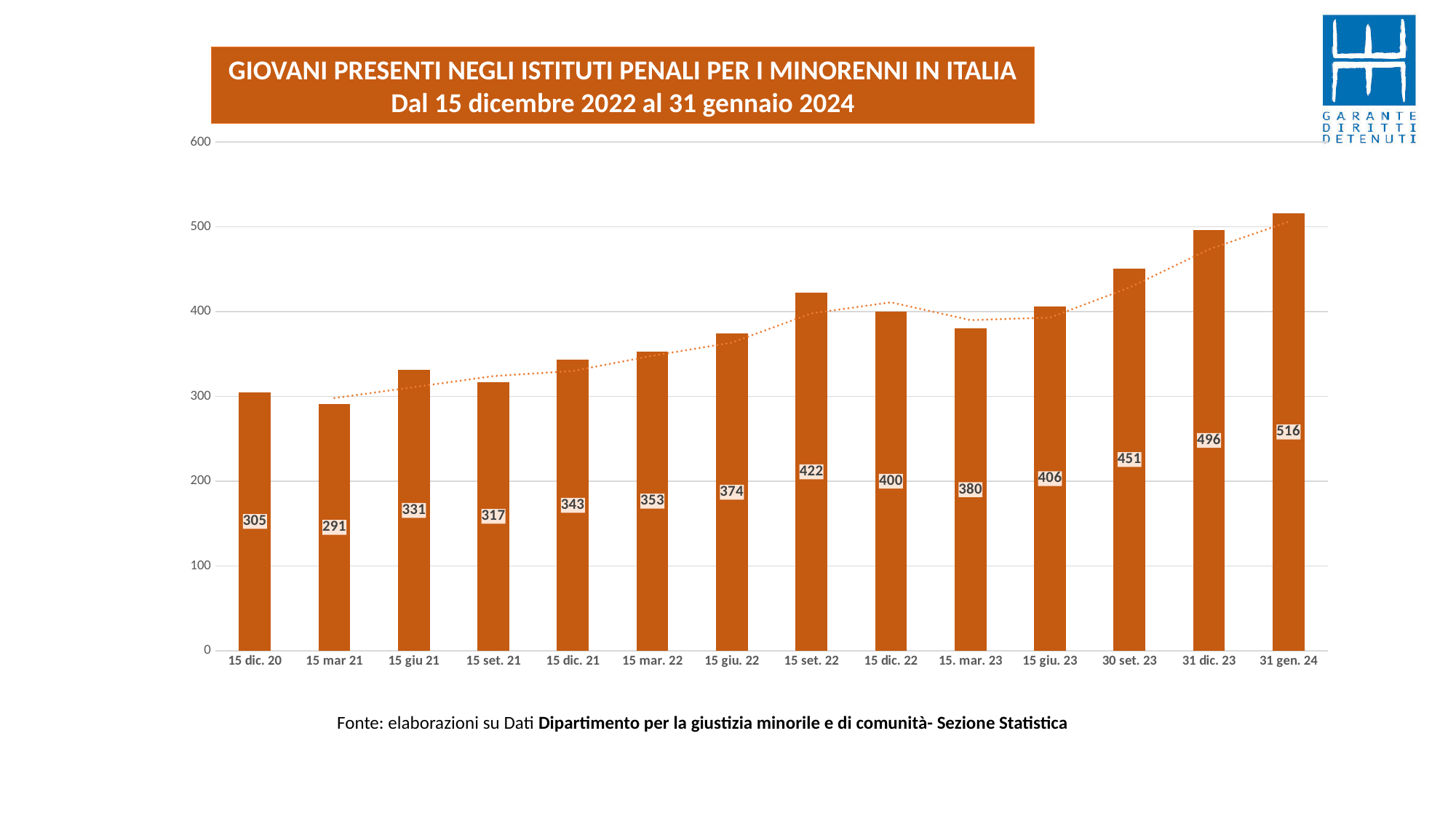
Which is larger, the value for 15 set. 22 or the value for 15 giu. 23? 15 set. 22 What is the difference between the values for 31 gen. 24 and 15 dic. 20? 211 Which category has the lowest value? 15 mar 21 How many categories are shown on the x axis? 14 What is the value for 15 set. 22? 422 Which category has the highest value? 31 gen. 24 What is the value for 31 gen. 24? 516 What kind of chart is shown on the slide? bar chart Is the value for 30 set. 23 greater or less than 400? greater What is the difference between the values for 15 set. 22 and 15 dic. 22? 22 What is the value for 15 dic. 20? 305 Do the values generally rise or fall from 15 dic. 20 to 31 gen. 24? rise